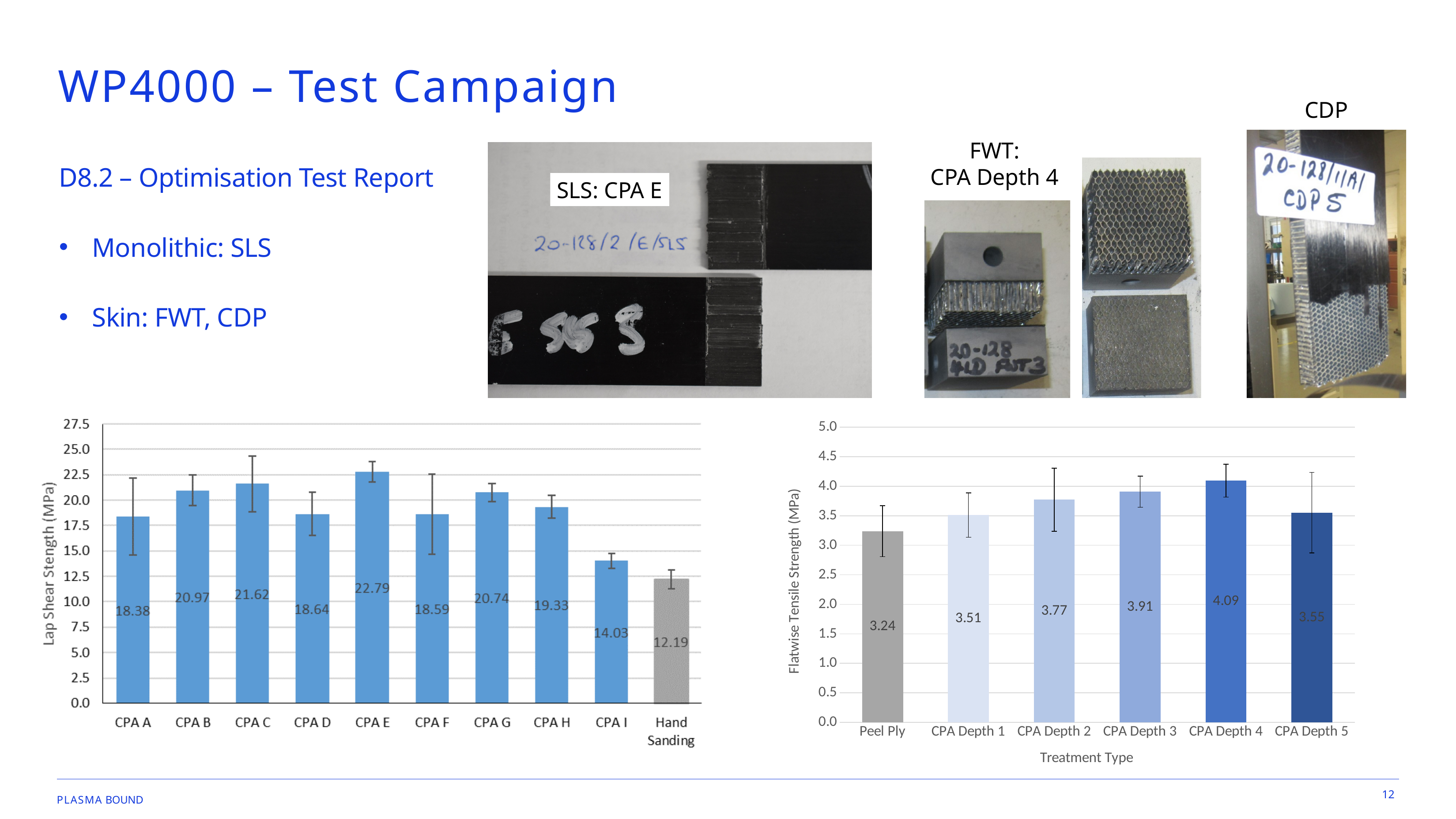
In the left chart (Lap Shear Strength), how many categories are shown on the x axis? 10 In the right chart (Flatwise Tensile Strength), which is larger, CPA Depth 2 or CPA Depth 5? CPA Depth 2 In the left chart (Lap Shear Strength), what is the value for CPA E? 22.79 What kind of chart is the right chart (Flatwise Tensile Strength)? Bar chart In the right chart (Flatwise Tensile Strength), which treatment type has the lowest value? Peel Ply In the left chart (Lap Shear Strength), which category has the highest value? CPA E In the left chart (Lap Shear Strength), which category has the lowest value? Hand Sanding In the right chart (Flatwise Tensile Strength), how many treatment types are shown? 6 In the right chart (Flatwise Tensile Strength), what is the difference between CPA Depth 4 and Peel Ply? 0.85 In the left chart (Lap Shear Strength), what is the difference between CPA E and Hand Sanding? 10.60 In the left chart (Lap Shear Strength), what is the value for Hand Sanding? 12.19 In the right chart (Flatwise Tensile Strength), what is the value for CPA Depth 4? 4.09